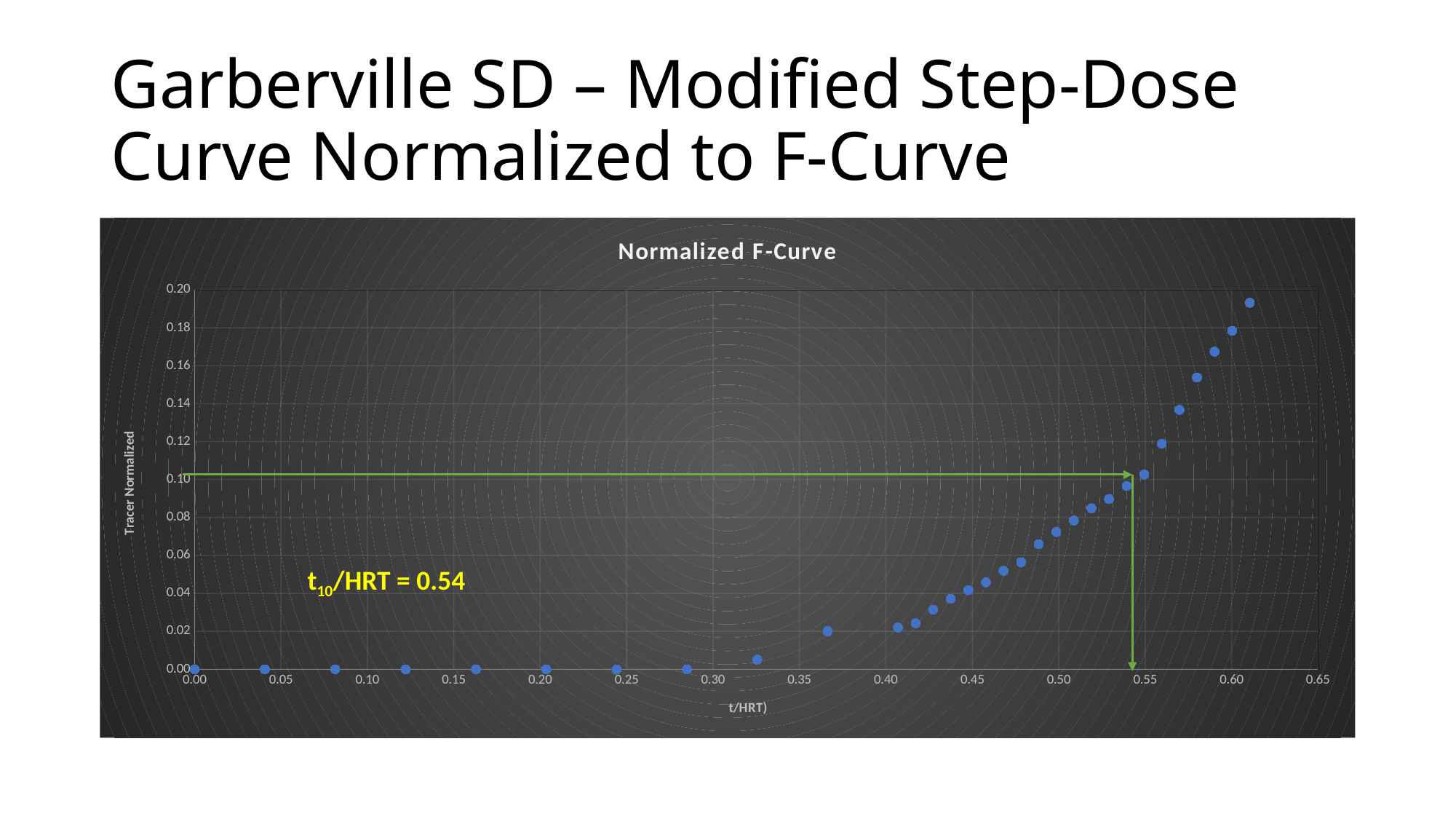
Do the plotted values rise or fall as t/HRT increases beyond 0.30? rise What is the Tracer Normalized value at t/HRT = 0.00? 0.00 What is the title of the chart? Normalized F-Curve Is the Tracer Normalized value at t/HRT = 0.50 greater or less than 0.10? less At which Tracer Normalized level is the horizontal green arrow drawn? 0.10 Is the Tracer Normalized value at t/HRT = 0.45 greater or less than 0.06? less Is the Tracer Normalized value at t/HRT = 0.60 greater or less than 0.14? greater What kind of chart is shown on the slide? scatter chart What value of t10/HRT is annotated on the chart? 0.54 What is the highest value shown on the y axis of the chart? 0.20 What is the label of the y axis of the chart? Tracer Normalized